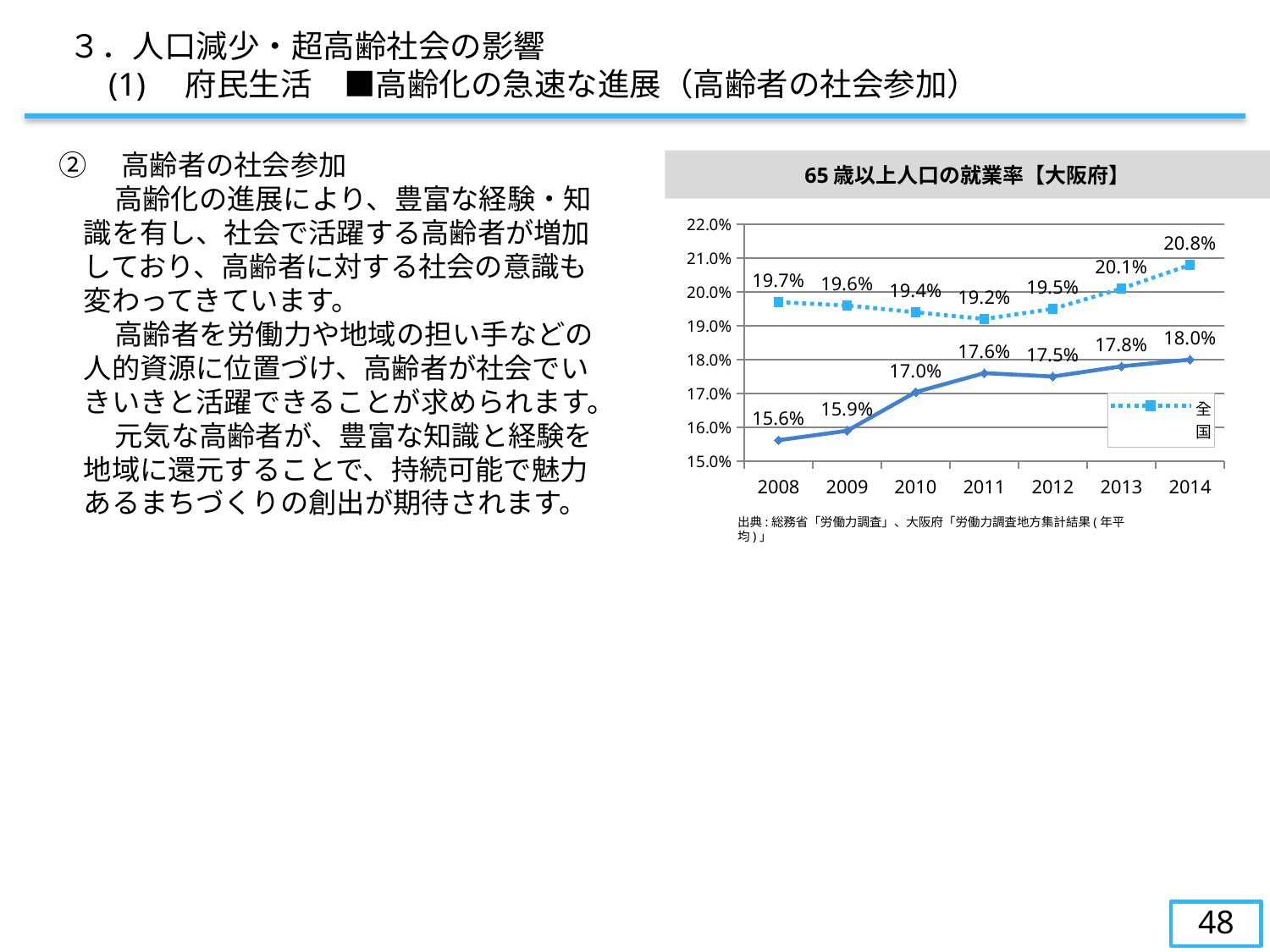
What is the difference between the 全国 value and the solid line value in 2014? 2.8% How many years are shown on the x axis? 7 Which is larger in 2010, the 全国 value or the solid line value? 全国 What is the title of the chart? 65歳以上人口の就業率【大阪府】 In which year is the 全国 value lowest? 2011 In which year is the solid line series highest? 2014 What is the value of the solid line series in 2008? 15.6% What is the difference between the solid line values in 2008 and 2014? 2.4% What is the value for 全国 in 2011? 19.2% What kind of chart is shown? Line chart What is the value for 全国 in 2014? 20.8% What is the value of the solid line series in 2012? 17.5%